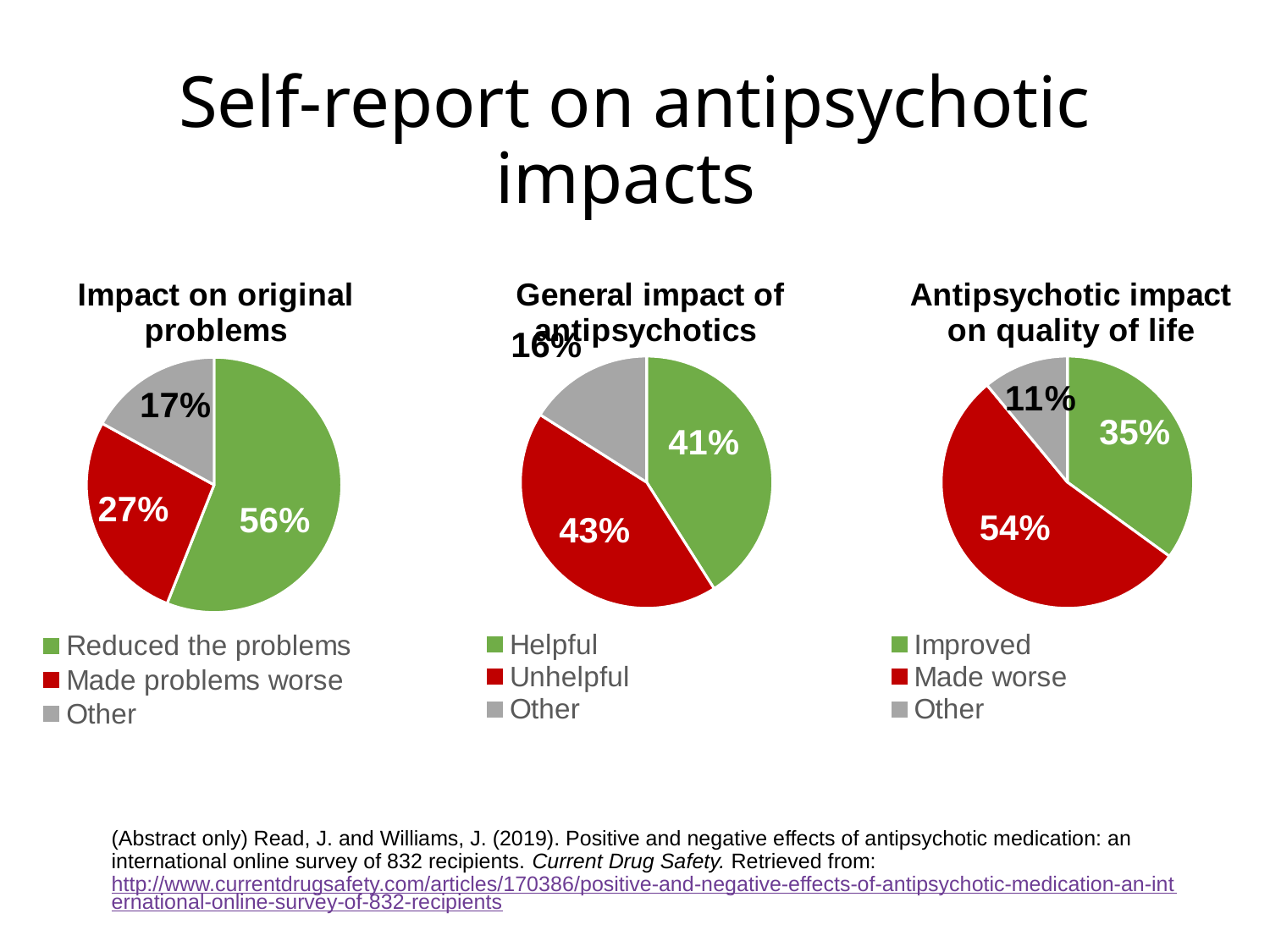
In the 'Impact on original problems' chart, what share of respondents said antipsychotics reduced the problems? 56% What type of chart is used for 'Antipsychotic impact on quality of life'? Pie chart In the 'Impact on original problems' chart, what percentage is shown for 'Made problems worse'? 27% In the 'Antipsychotic impact on quality of life' chart, what is the difference between the 'Made worse' and 'Improved' percentages? 19% In the 'Antipsychotic impact on quality of life' chart, what percentage is shown for 'Improved'? 35% In the 'General impact of antipsychotics' chart, what colour represents 'Other'? Grey In the 'Antipsychotic impact on quality of life' chart, which category has the largest slice? Made worse In the 'General impact of antipsychotics' chart, which is larger: Helpful or Unhelpful? Unhelpful In the 'Impact on original problems' chart, what is the difference between 'Reduced the problems' and 'Made problems worse'? 29% How many slices does the 'General impact of antipsychotics' chart have? 3 In the 'General impact of antipsychotics' chart, what percentage of respondents found antipsychotics unhelpful? 43% In the 'Impact on original problems' chart, which category has the smallest slice? Other